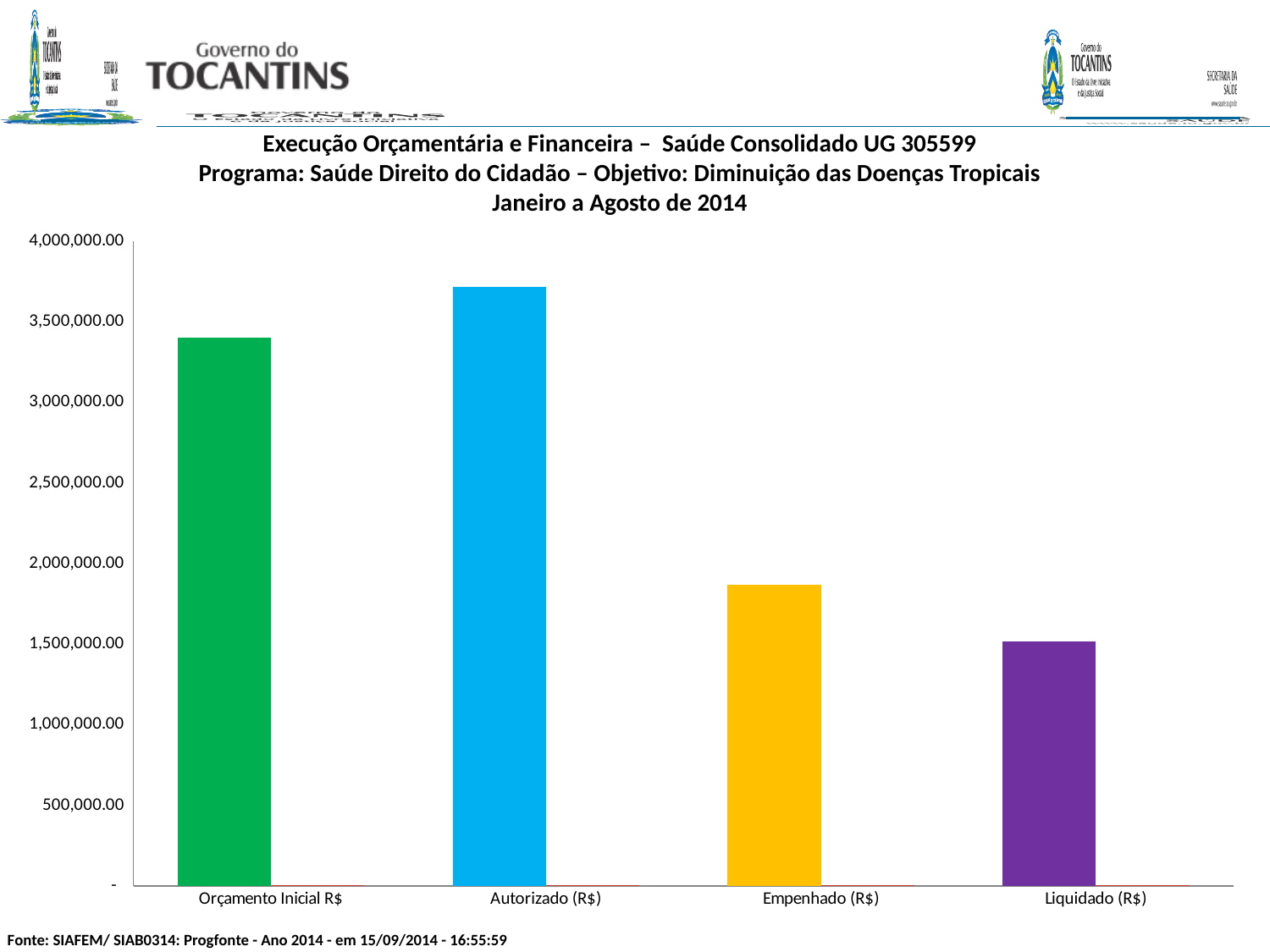
How many categories are plotted on the x axis? 4 Which is larger, Empenhado (R$) or Liquidado (R$)? Empenhado (R$) What kind of chart is shown on the slide? bar chart Is the value for Autorizado (R$) greater or less than 3,500,000.00? greater Is the value for Liquidado (R$) greater or less than 2,000,000.00? less What colour is the bar for Autorizado (R$)? blue Which is larger, Orçamento Inicial R$ or Autorizado (R$)? Autorizado (R$) Is the value for Empenhado (R$) greater or less than 2,000,000.00? less Which category has the highest value? Autorizado (R$) What period does the chart title say the data covers? Janeiro a Agosto de 2014 Which category has the lowest value? Liquidado (R$)